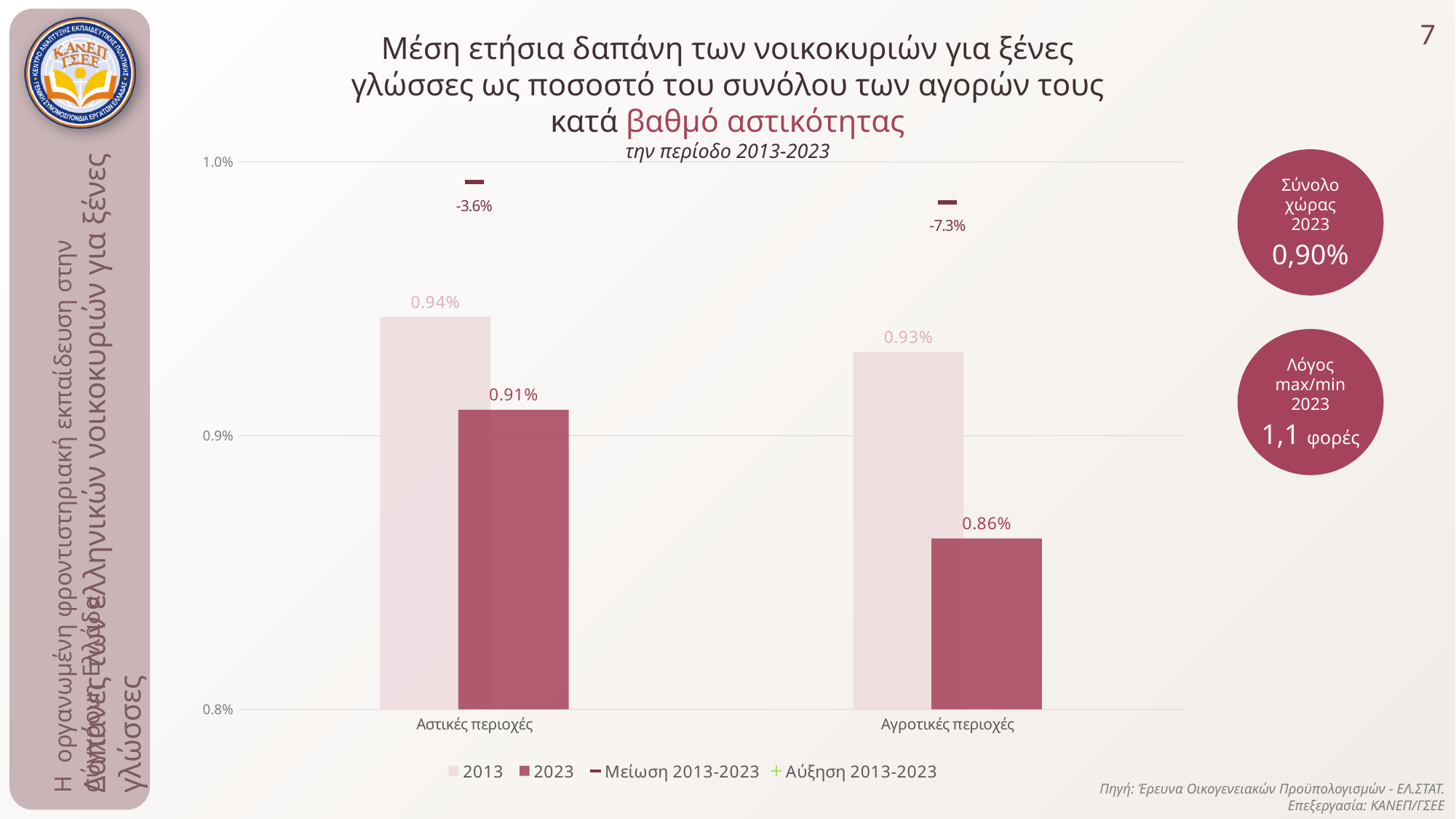
What is the difference between the 2013 and 2023 values for Αγροτικές περιοχές? 0.07% Which is larger: the 2023 value for Αστικές περιοχές or the 2023 value for Αγροτικές περιοχές? Αστικές περιοχές Which category has the highest value in the 2013 series? Αστικές περιοχές What is the value for Αστικές περιοχές in the 2013 series? 0.94% What kind of chart is shown on the slide? bar chart What is the value for Αγροτικές περιοχές in the 2023 series? 0.86% Which category has the lowest value in the 2023 series? Αγροτικές περιοχές What percentage change (Μείωση 2013-2023) is shown for Αγροτικές περιοχές? -7.3% How many categories are shown on the x axis? 2 How many entries does the legend list? 4 Is the 2023 value for Αγροτικές περιοχές greater or less than 0.9%? less What is the value for Αστικές περιοχές in the 2023 series? 0.91%